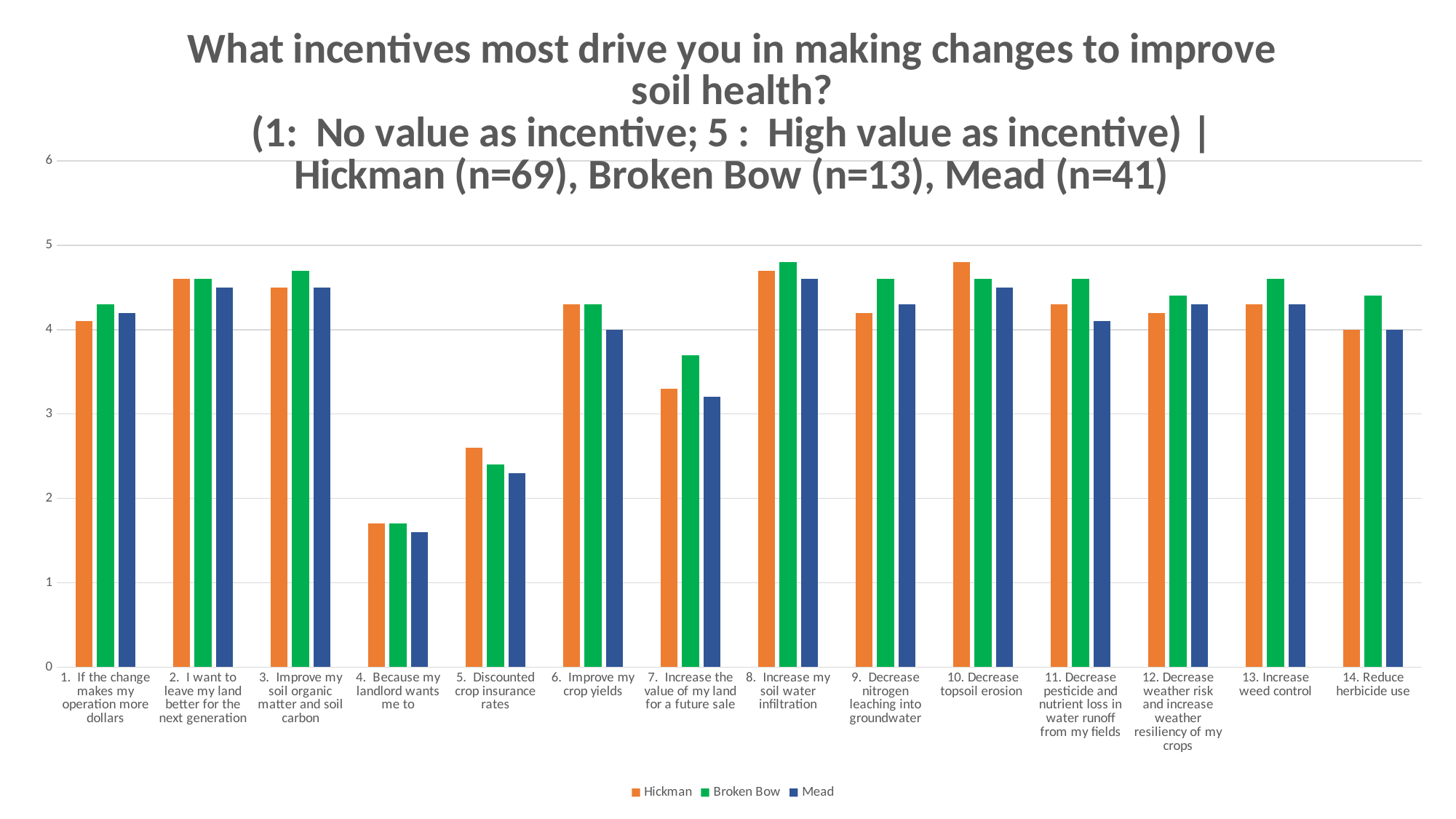
What kind of chart is shown on the slide? bar chart Is the Hickman value for '4. Because my landlord wants me to' greater or less than 2? less How many incentive categories are shown along the x axis? 14 For '5. Discounted crop insurance rates', which is larger: the Hickman value or the Mead value? Hickman For '7. Increase the value of my land for a future sale', which is larger: the Hickman value or the Broken Bow value? Broken Bow Which category has the lowest Hickman value? 4. Because my landlord wants me to Which colour represents the Mead series in the legend? blue Is the Hickman value for '5. Discounted crop insurance rates' greater or less than 2? greater Which category has the lowest Mead value? 4. Because my landlord wants me to How many series does the legend list? 3 Is the Hickman value for '10. Decrease topsoil erosion' greater or less than 4? greater